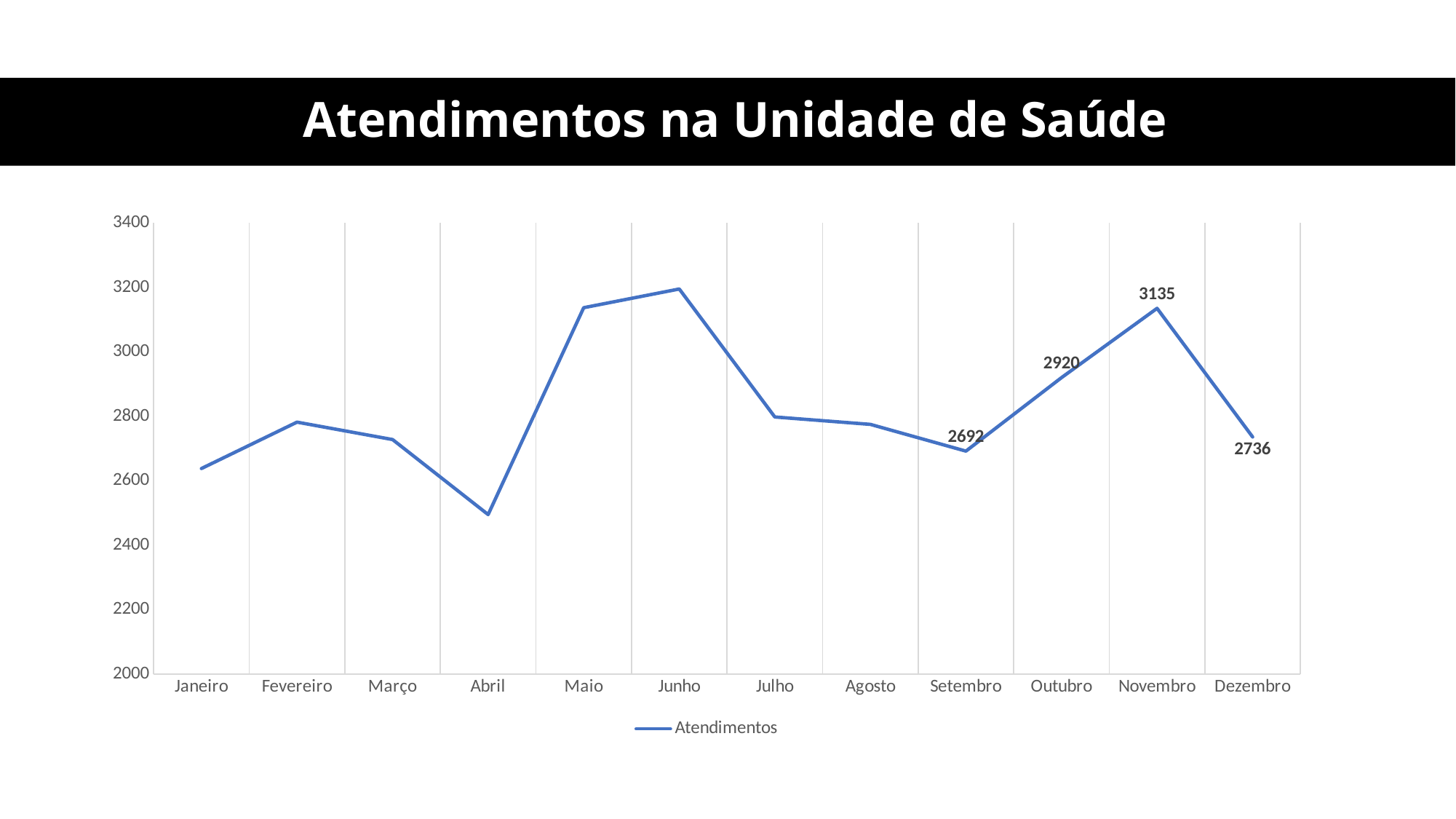
What is the difference between the values for Novembro and Outubro? 215 What is the difference between the values for Novembro and Dezembro? 399 How many months are plotted on the x axis? 12 What is the value for Setembro? 2692 Which month has the lowest value? Abril Is the value for Maio greater or less than 3000? greater Do the values rise or fall from Setembro to Novembro? Rise Is the value for Abril greater or less than 2600? less What is the value for Novembro? 3135 What type of chart is shown on the slide? Line chart Which is larger, the value for Outubro or the value for Setembro? Outubro What is the value for Dezembro? 2736